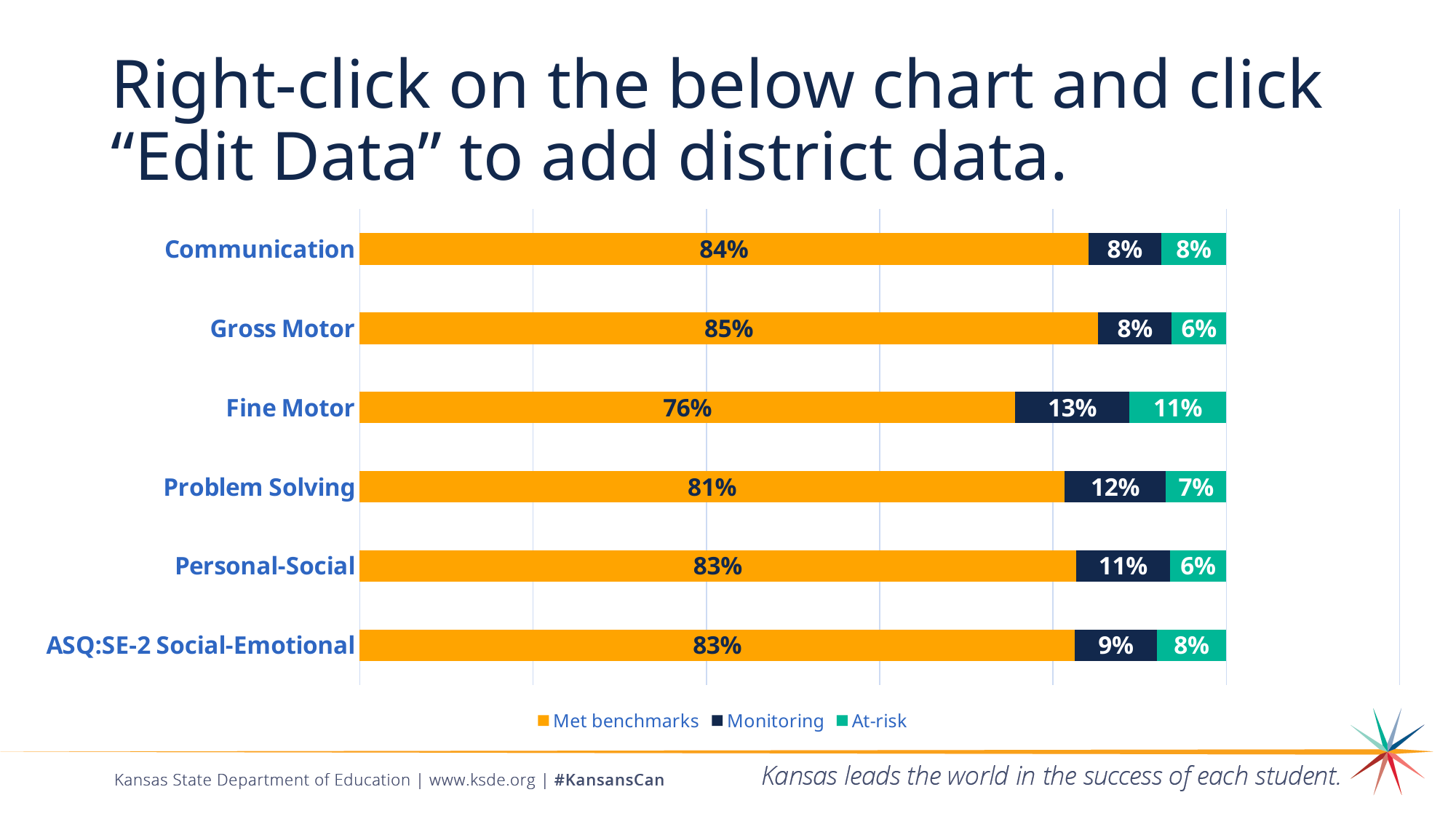
How many categories are shown on the chart? 6 What colour represents the At-risk series? Green What is the At-risk value for Gross Motor? 6% Which category has the highest At-risk percentage? Fine Motor What is the difference between the Met benchmarks values for Gross Motor and Fine Motor? 9% What percentage of students met benchmarks in Fine Motor? 76% What is the Monitoring value for Problem Solving? 12% What kind of chart is shown on the slide? Stacked bar chart Which is larger, the Monitoring value for Personal-Social or the Monitoring value for Communication? Personal-Social Which category has the lowest Met benchmarks percentage? Fine Motor How many series does the legend list? 3 Which category has the highest Met benchmarks percentage? Gross Motor